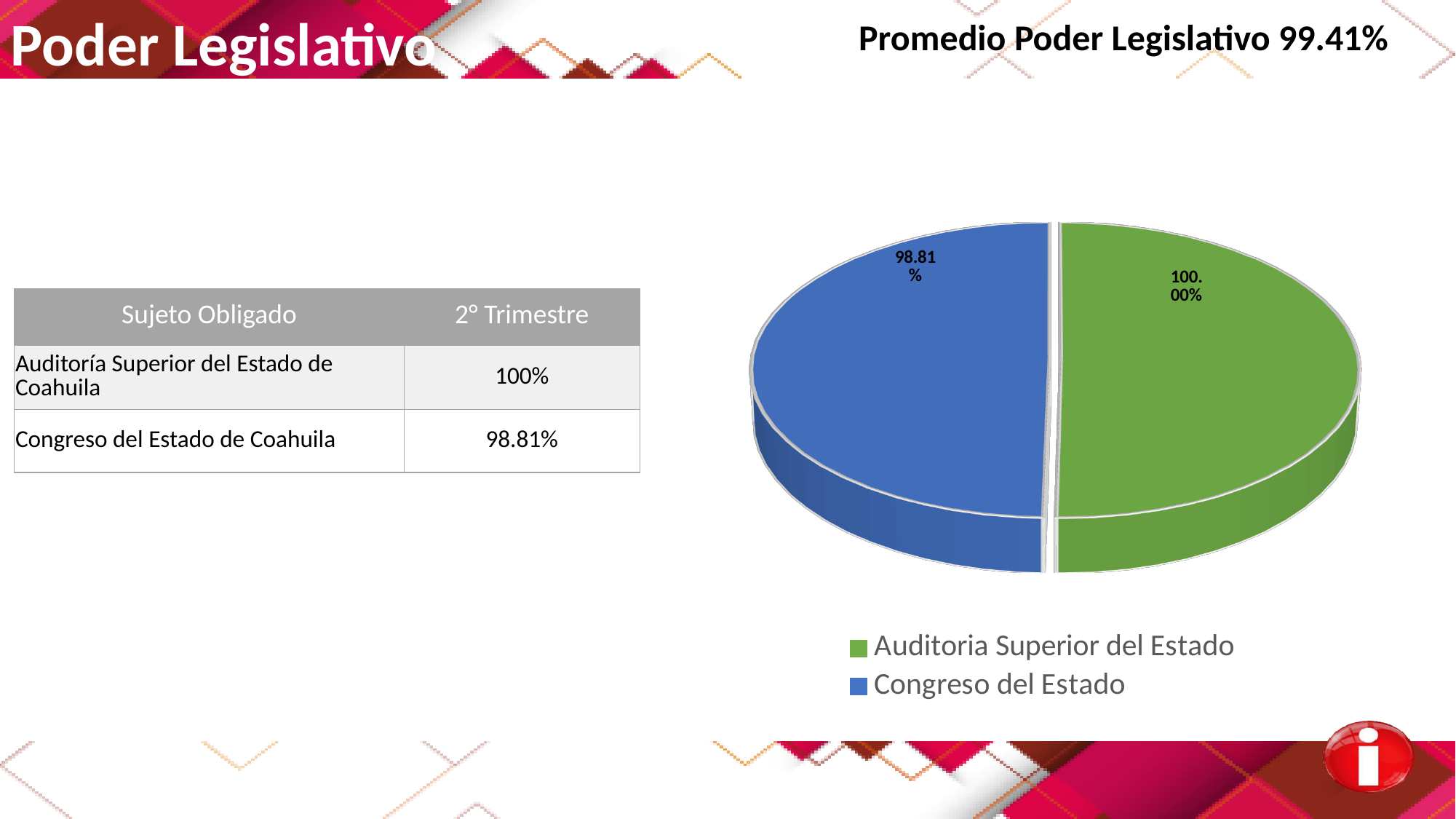
What value is shown on the pie slice for Auditoria Superior del Estado? 100.00% How many entries does the chart legend list? 2 How many slices does the pie chart have? 2 Which category has the higher labelled value in the pie chart? Auditoria Superior del Estado What kind of chart is shown on the slide? pie chart What colour is the slice for Congreso del Estado? blue Is the labelled value for Congreso del Estado larger or smaller than that for Auditoria Superior del Estado? smaller Which category has the lower labelled value in the pie chart? Congreso del Estado What is the difference between the labelled values for Auditoria Superior del Estado and Congreso del Estado? 1.19% Which legend entry is shown in green? Auditoria Superior del Estado What value is shown on the pie slice for Congreso del Estado? 98.81%